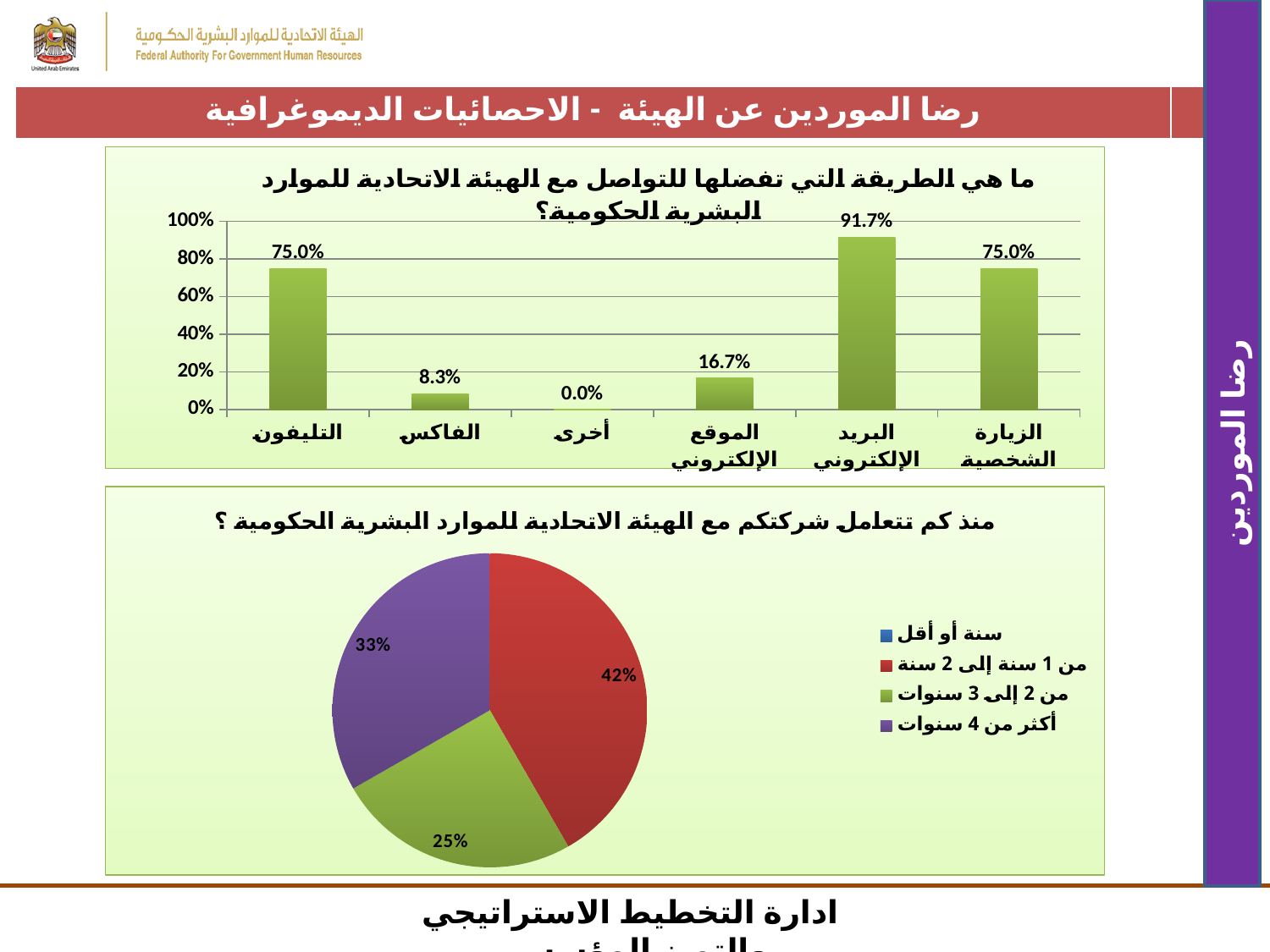
In the top bar chart, what is the value for البريد الإلكتروني? 91.7% In the bottom pie chart, what share does من 1 سنة إلى 2 سنة have? 42% In the bottom pie chart, what share does أكثر من 4 سنوات have? 33% In the top bar chart, what is the difference between the values for البريد الإلكتروني and التليفون? 16.7% What kind of chart is the top chart on the slide? bar chart How many categories are shown in the top bar chart? 6 In the top bar chart, which category has the highest value? البريد الإلكتروني In the top bar chart, what is the value for الفاكس? 8.3% In the top bar chart, which category has the lowest value? أخرى In the top bar chart, what is the value for الموقع الإلكتروني? 16.7% In the top bar chart, which is larger: the value for الفاكس or the value for الموقع الإلكتروني? الموقع الإلكتروني How many entries does the legend of the bottom pie chart list? 4